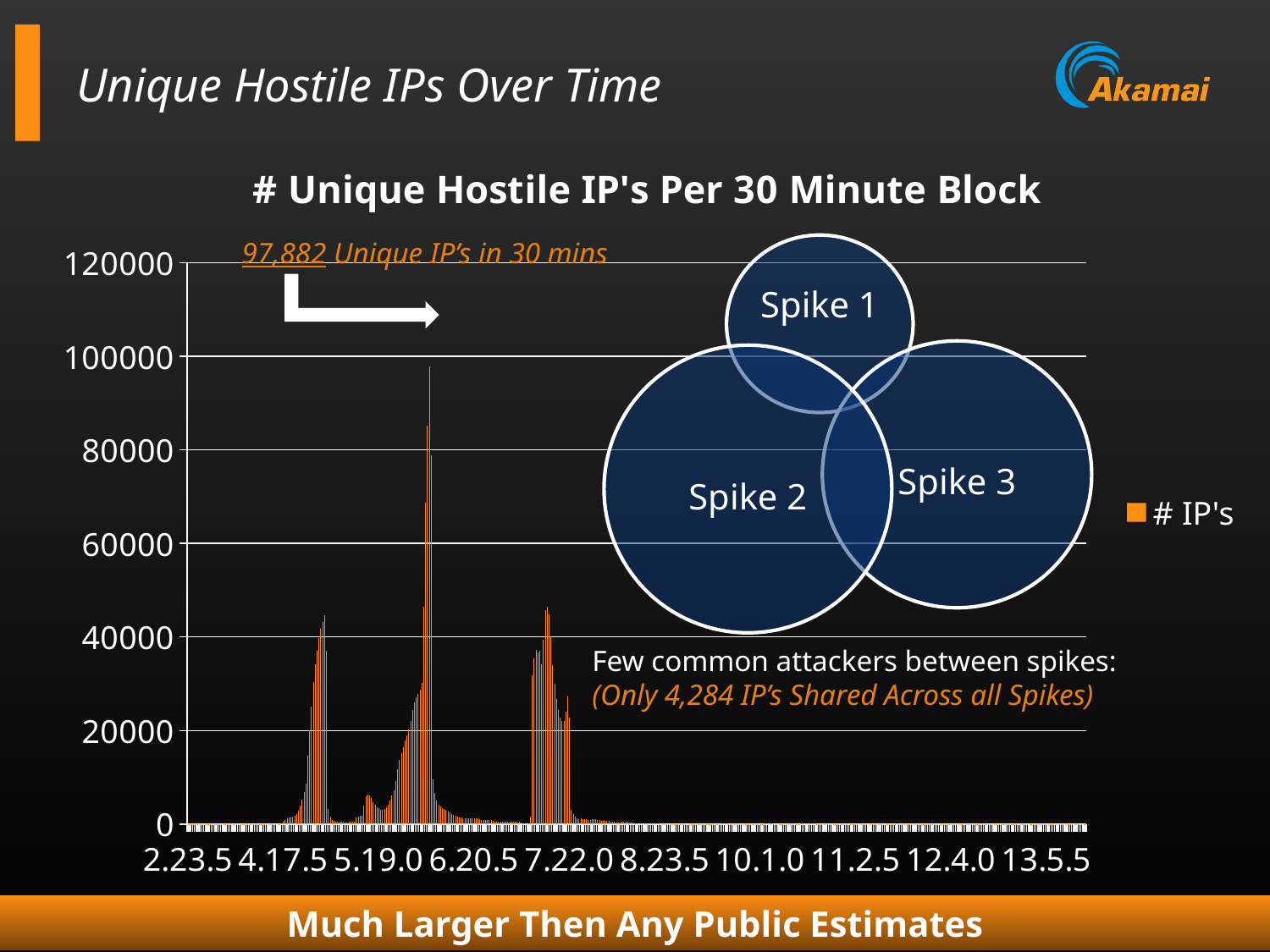
What kind of chart is shown on the slide? bar chart Is the peak of the first spike (near the 4.17.5 label) greater or less than 40000? greater Is the highest bar on the chart greater or less than 80000? greater What is the highest value shown on the y axis of the chart? 120000 Is the peak of the third spike (near the 7.22.0 label) greater or less than 60000? less How many series does the chart legend list? 1 What is the title of the chart? # Unique Hostile IP's Per 30 Minute Block How many labels are shown along the x axis of the chart? 10 According to the annotation on the chart, what is the peak number of unique hostile IPs in a 30-minute block? 97,882 What is the name of the series shown in the legend? # IP's